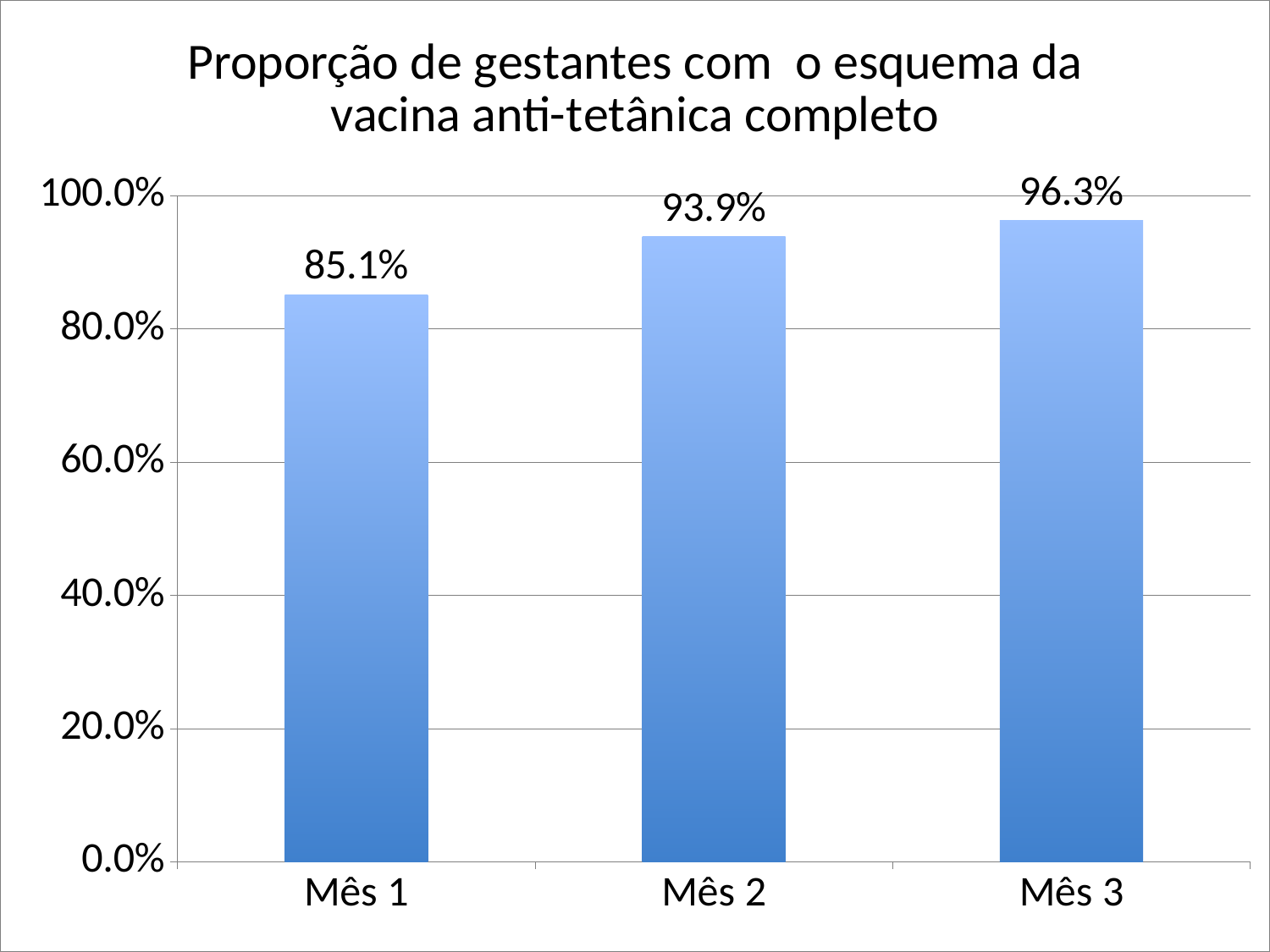
How many months are shown on the x axis? 3 What kind of chart is shown on the slide? bar chart What is the value for Mês 3? 96.3% Which month has the highest value? Mês 3 Which is larger, the value for Mês 1 or the value for Mês 2? Mês 2 Is the value for Mês 1 greater or less than 80.0%? greater What is the difference between the values for Mês 2 and Mês 1? 8.8% What is the value for Mês 2? 93.9% What is the value for Mês 1? 85.1% What is the difference between the values for Mês 3 and Mês 1? 11.2% Which month has the lowest value? Mês 1 Do the values rise or fall from Mês 1 to Mês 3? rise